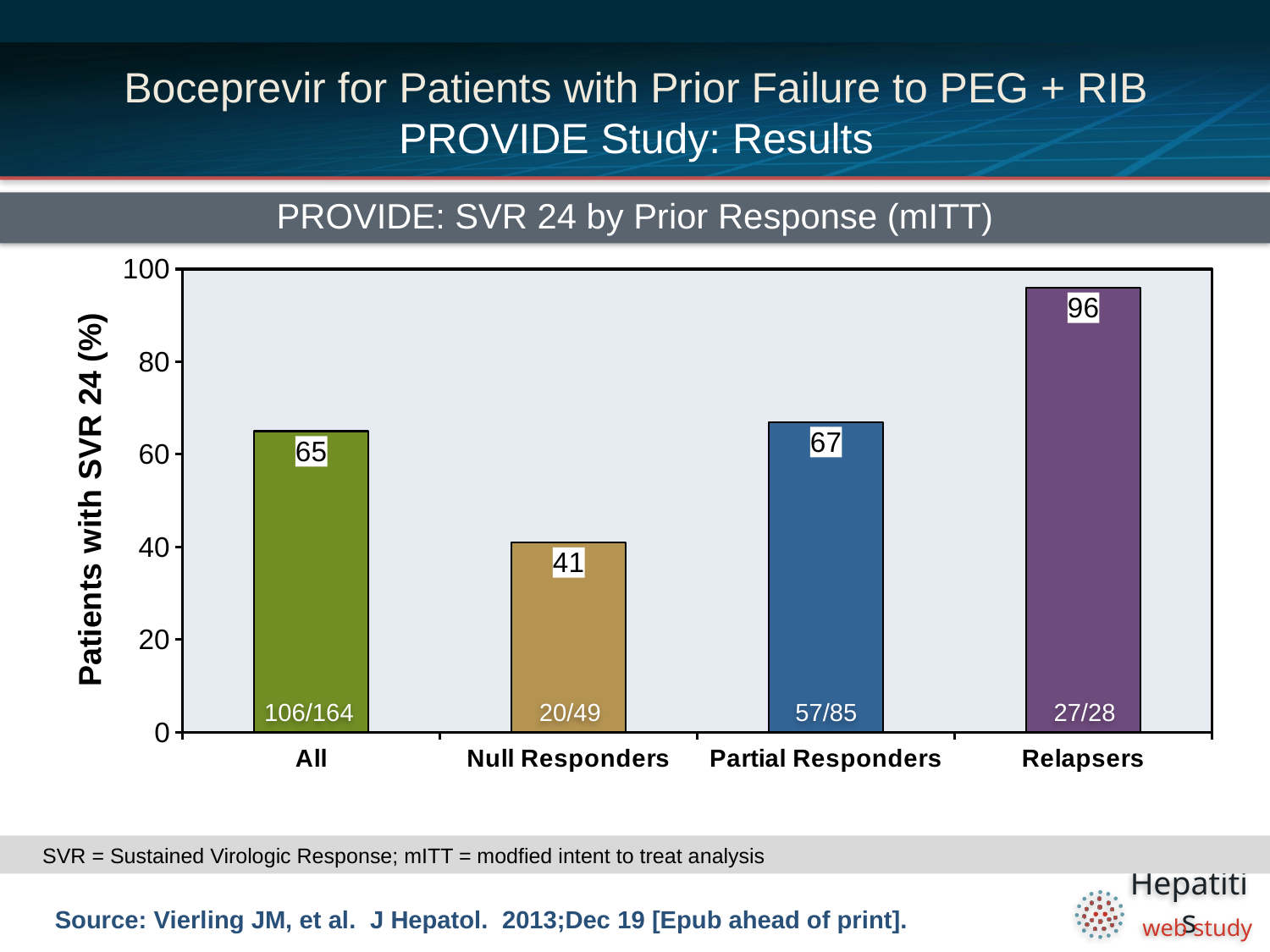
What fraction of patients is shown inside the bar for the All group? 106/164 What is the label of the y axis? Patients with SVR 24 (%) What is the SVR 24 rate for Partial Responders? 67 Which category has the lowest SVR 24 rate? Null Responders How many categories are shown on the x axis? 4 What is the SVR 24 rate for Null Responders? 41 What is the difference in SVR 24 rate between Relapsers and Null Responders? 55 Which has a higher SVR 24 rate, Partial Responders or All? Partial Responders What kind of chart is shown on the slide? Bar chart What is the title of the chart? PROVIDE: SVR 24 by Prior Response (mITT) Which category has the highest SVR 24 rate? Relapsers What is the SVR 24 rate for Relapsers? 96